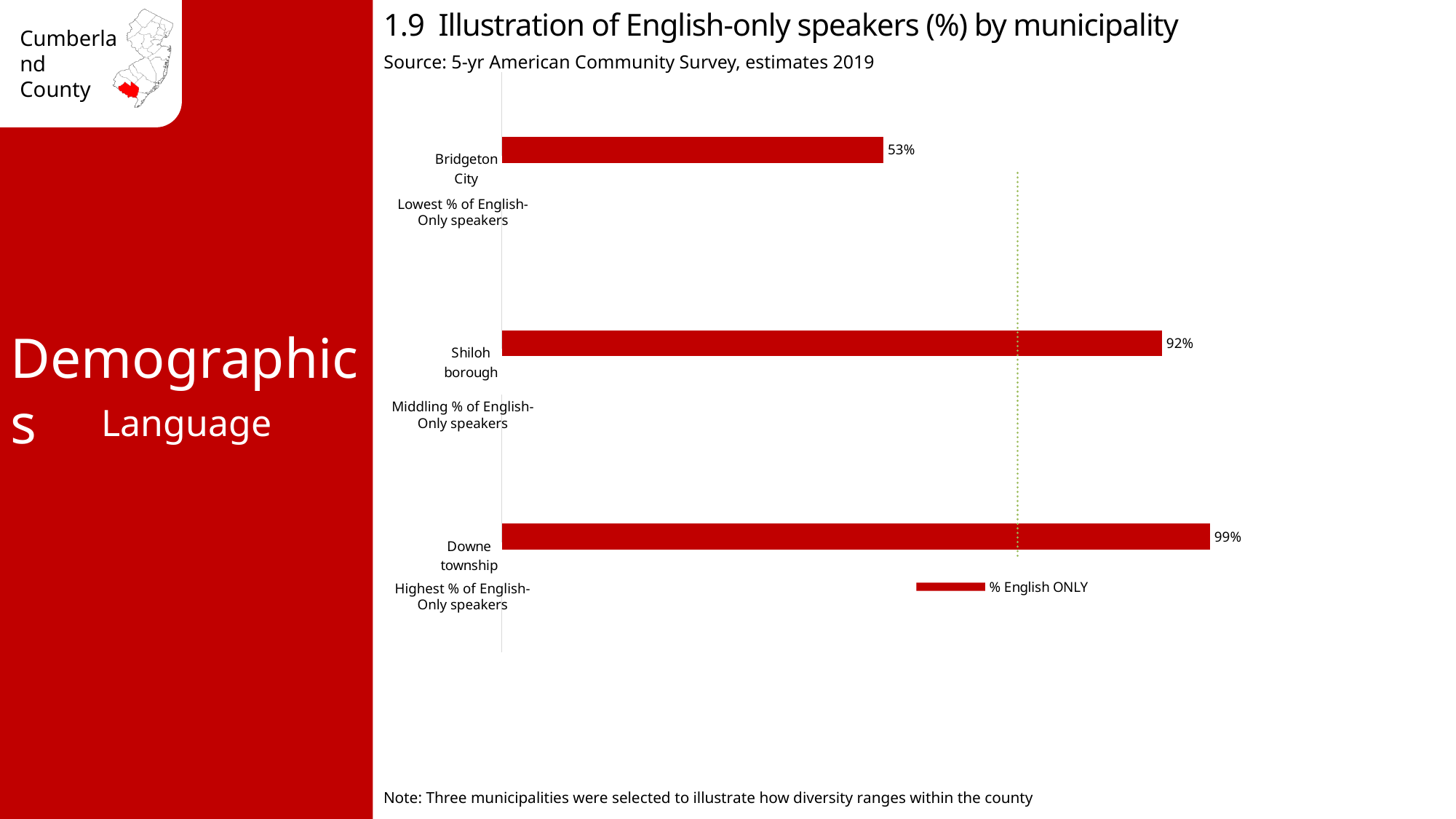
What is the difference in percentage points between Shiloh borough and Bridgeton City? 39 Which has a higher percentage of English-only speakers, Shiloh borough or Bridgeton City? Shiloh borough What is the percentage of English-only speakers in Bridgeton City? 53% How many municipalities are shown in the chart? 3 What kind of chart is shown on the slide? Bar chart What is the percentage of English-only speakers in Downe township? 99% How many series does the legend list? 1 What is the difference in percentage points between Downe township and Bridgeton City? 46 Which municipality has the lowest percentage of English-only speakers? Bridgeton City What is the percentage of English-only speakers in Shiloh borough? 92% Which municipality has the highest percentage of English-only speakers? Downe township What is the legend entry for the series shown in the chart? % English ONLY